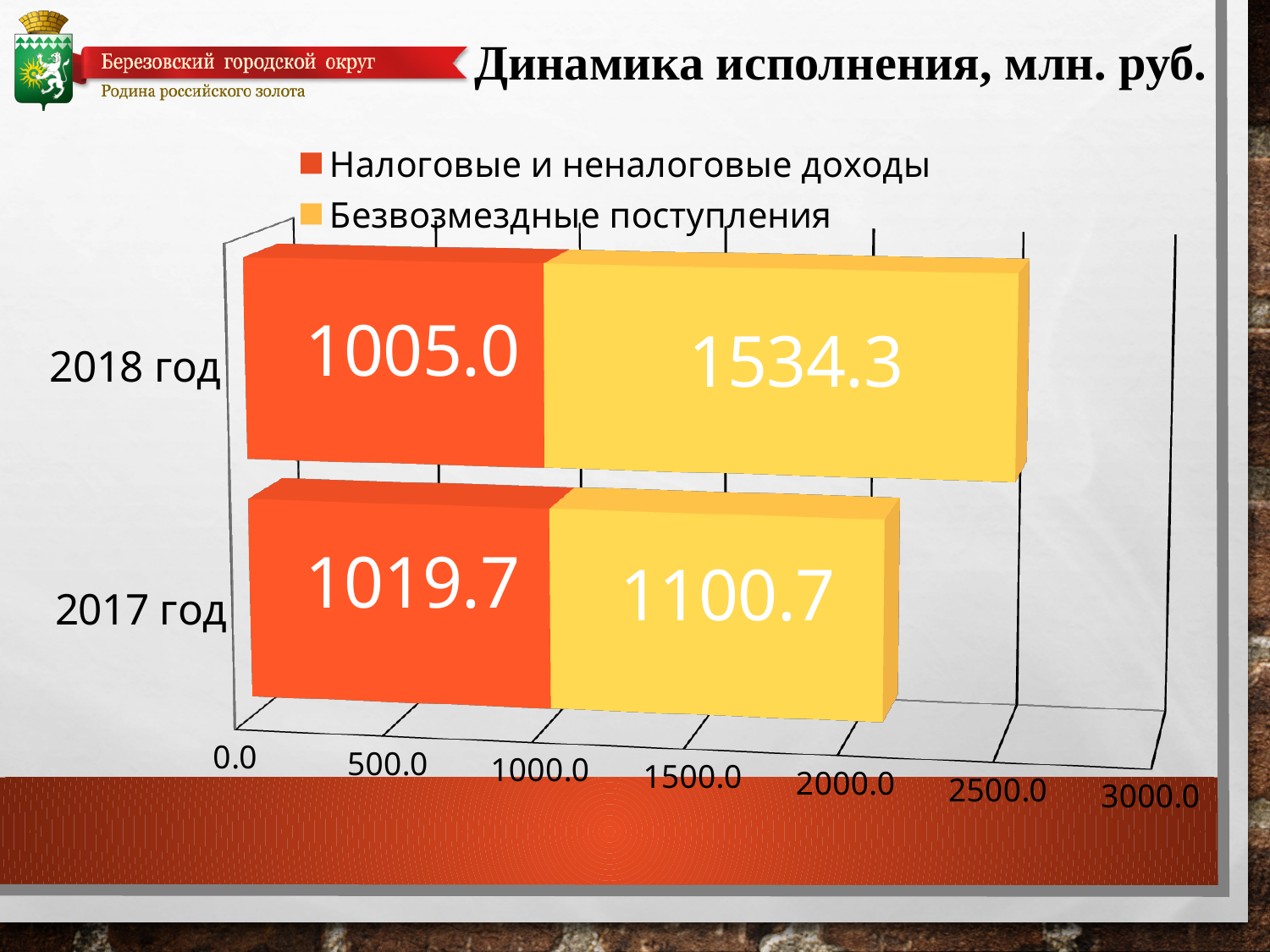
What is the total of the stacked bar for 2017 год? 2120.4 What is the value of Безвозмездные поступления for 2017 год? 1100.7 Which year has the higher value for Безвозмездные поступления? 2018 год What is the difference between Налоговые и неналоговые доходы in 2017 год and 2018 год? 14.7 What is the total of the stacked bar for 2018 год? 2539.3 What is the title of the chart? Динамика исполнения, млн. руб. What is the value of Налоговые и неналоговые доходы for 2018 год? 1005.0 What is the value of Безвозмездные поступления for 2018 год? 1534.3 What is the value of Налоговые и неналоговые доходы for 2017 год? 1019.7 What is the difference between Безвозмездные поступления in 2018 год and 2017 год? 433.6 What kind of chart is shown on the slide? Stacked bar chart How many series does the legend list? 2